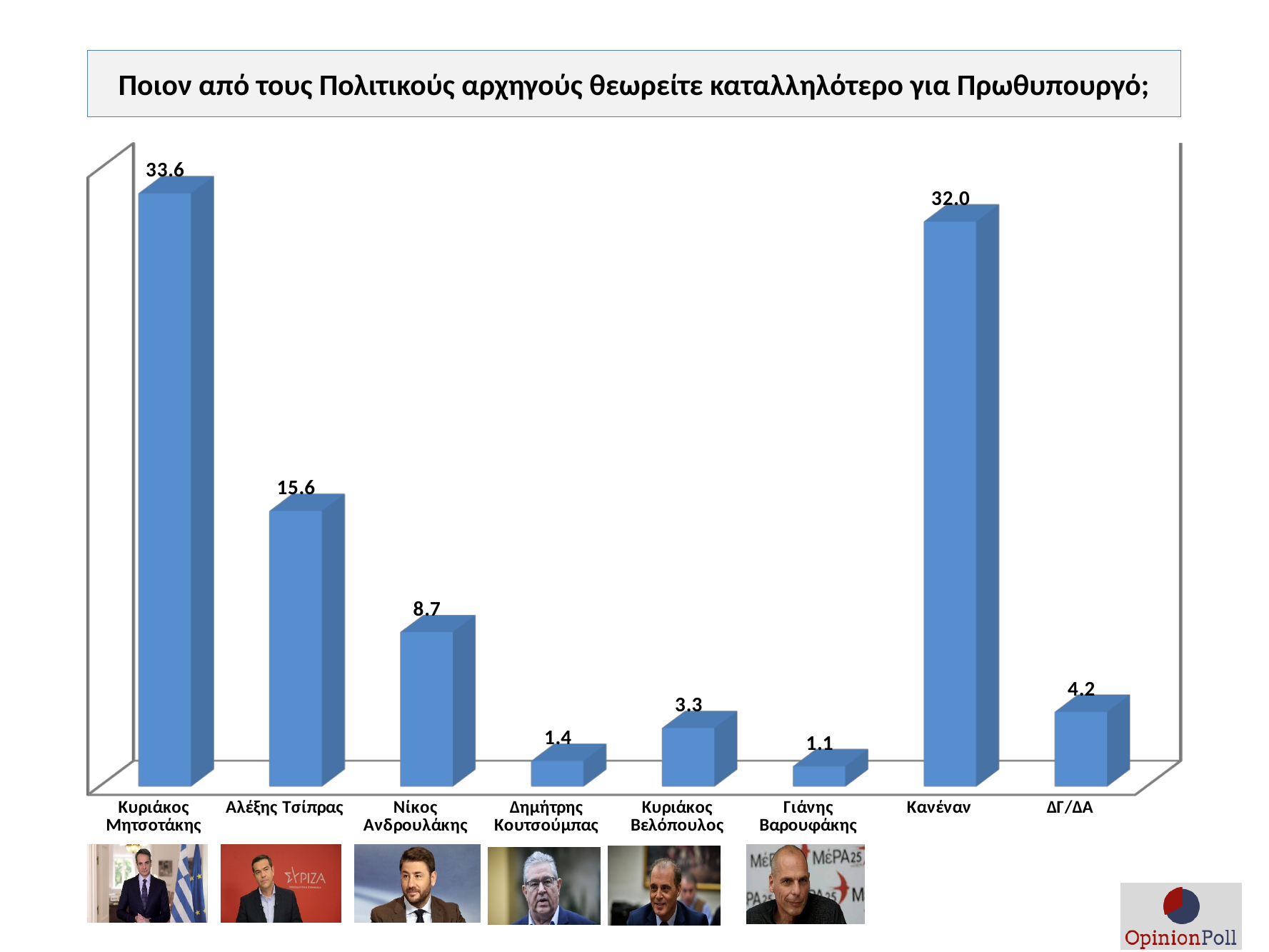
What is the title of the chart? Ποιον από τους Πολιτικούς αρχηγούς θεωρείτε καταλληλότερο για Πρωθυπουργό; What is the value for ΔΓ/ΔΑ? 4.2 What kind of chart is shown on the slide? bar chart What is the value for Κανέναν? 32.0 What is the value for Κυριάκος Μητσοτάκης? 33.6 Which category has the lowest value? Γιάνης Βαρουφάκης Which is larger, the value for Κυριάκος Βελόπουλος or the value for Δημήτρης Κουτσούμπας? Κυριάκος Βελόπουλος What is the difference between the values for Κυριάκος Μητσοτάκης and Κανέναν? 1.6 What is the value for Αλέξης Τσίπρας? 15.6 What is the difference between the values for Αλέξης Τσίπρας and Νίκος Ανδρουλάκης? 6.9 How many categories are shown on the x axis? 8 Which category has the highest value? Κυριάκος Μητσοτάκης